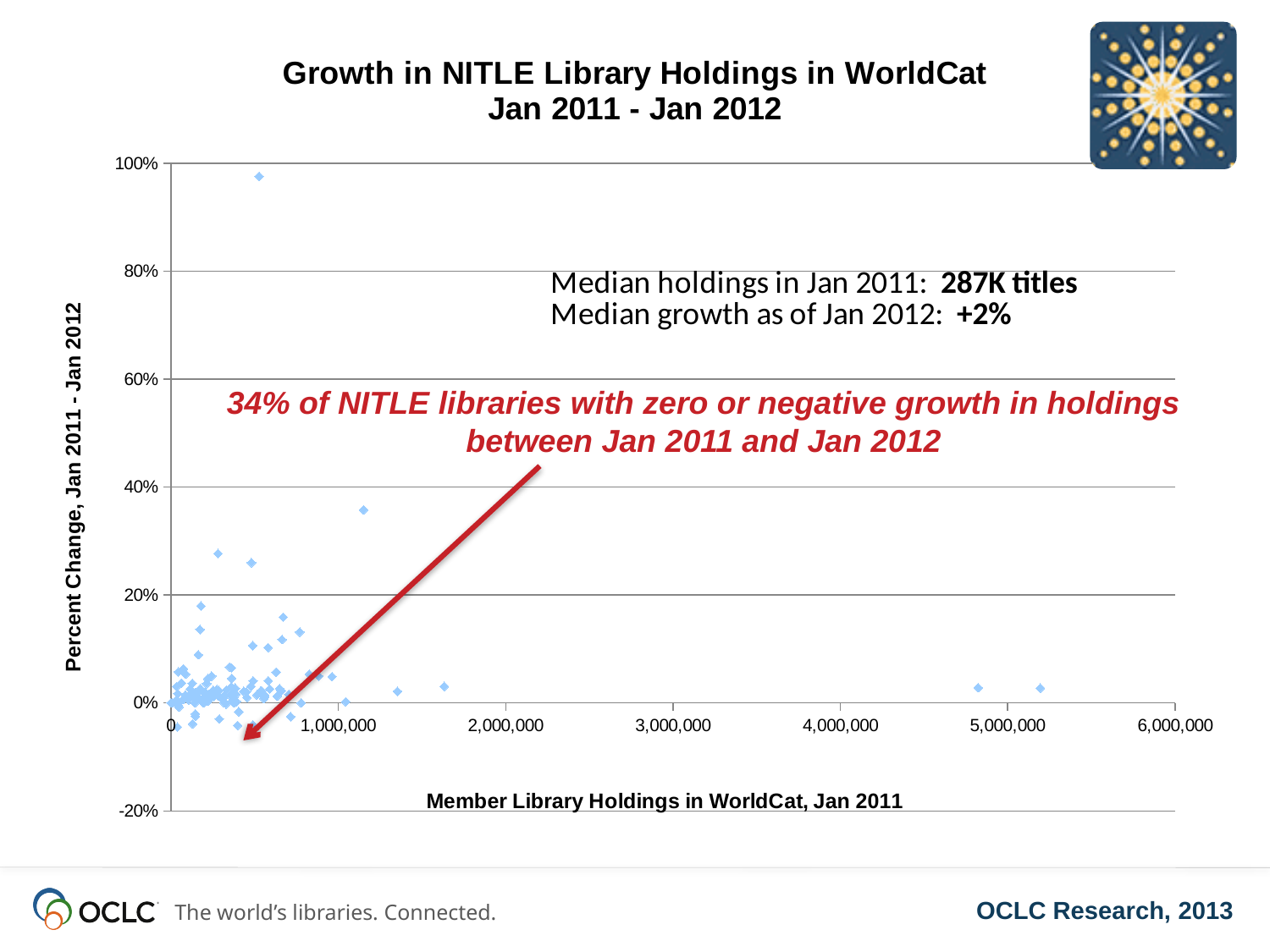
What kind of chart is shown on the slide? Scatter chart Is the holdings value for the point furthest to the right on the chart greater or less than 5,000,000? greater What is the highest value shown on the x axis? 6,000,000 What percentage of NITLE libraries had zero or negative growth in holdings between Jan 2011 and Jan 2012, according to the chart annotation? 34% What is the lowest value shown on the y axis? -20% What is the title of the chart? Growth in NITLE Library Holdings in WorldCat Jan 2011 - Jan 2012 Is the percent change for the highest point on the chart greater or less than 80%? greater What is the median holdings in Jan 2011 stated on the chart? 287K titles What is the median growth as of Jan 2012 stated on the chart? +2% What is the label of the x axis? Member Library Holdings in WorldCat, Jan 2011 What is the highest value shown on the y axis? 100%